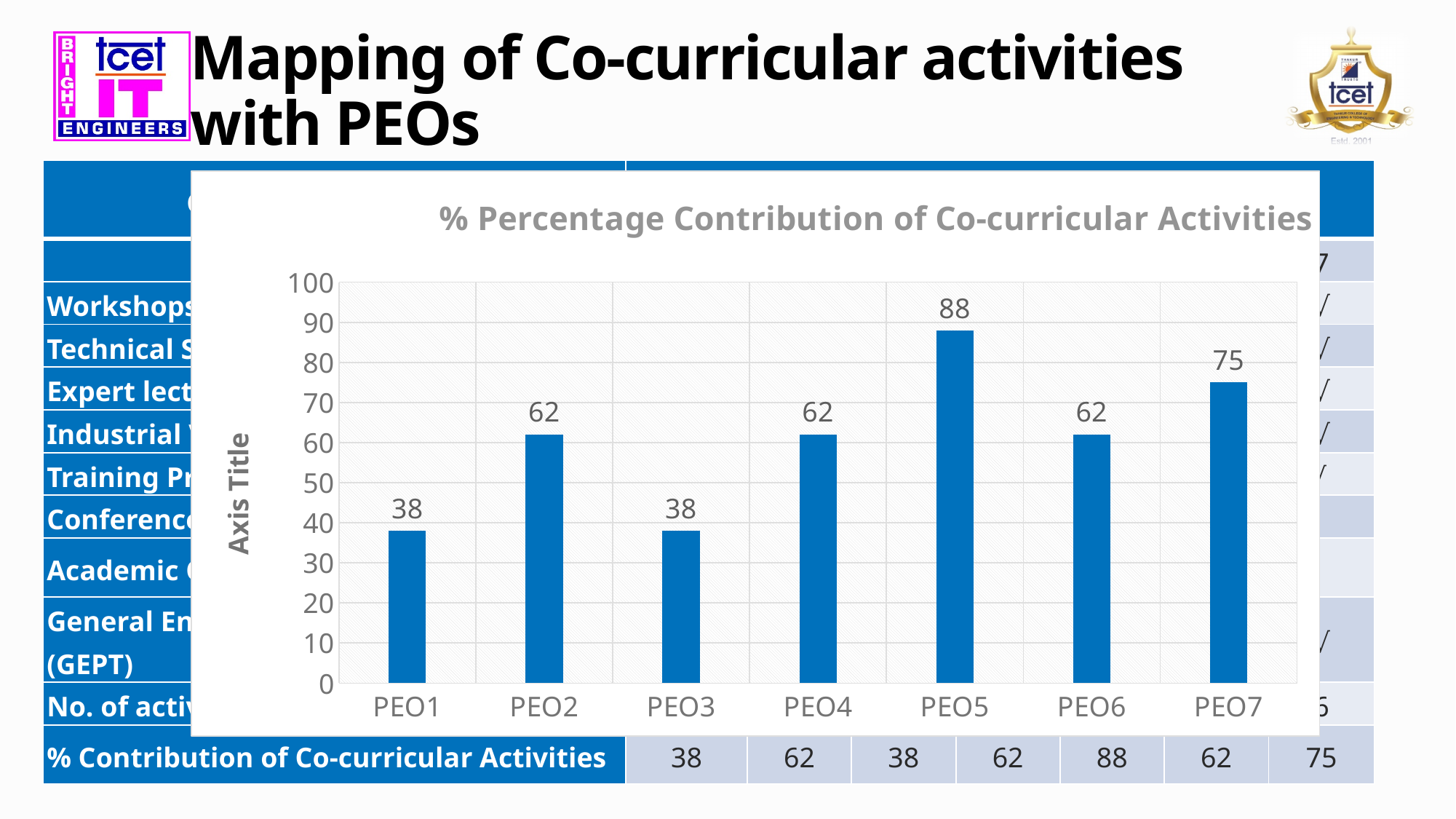
Which PEO has the highest value in the chart? PEO5 What is the value for PEO5 in the chart? 88 What is the label on the vertical axis of the chart? Axis Title How many PEO categories are shown on the x axis of the chart? 7 Is the value for PEO5 greater or less than 80? greater What is the value for PEO7 in the chart? 75 What is the difference between the values for PEO5 and PEO7? 13 What is the difference between the values for PEO2 and PEO1? 24 What kind of chart is shown on the slide? bar chart What is the value for PEO1 in the chart? 38 What is the title of the chart? % Percentage Contribution of Co-curricular Activities Which is larger, the value for PEO4 or the value for PEO3? PEO4